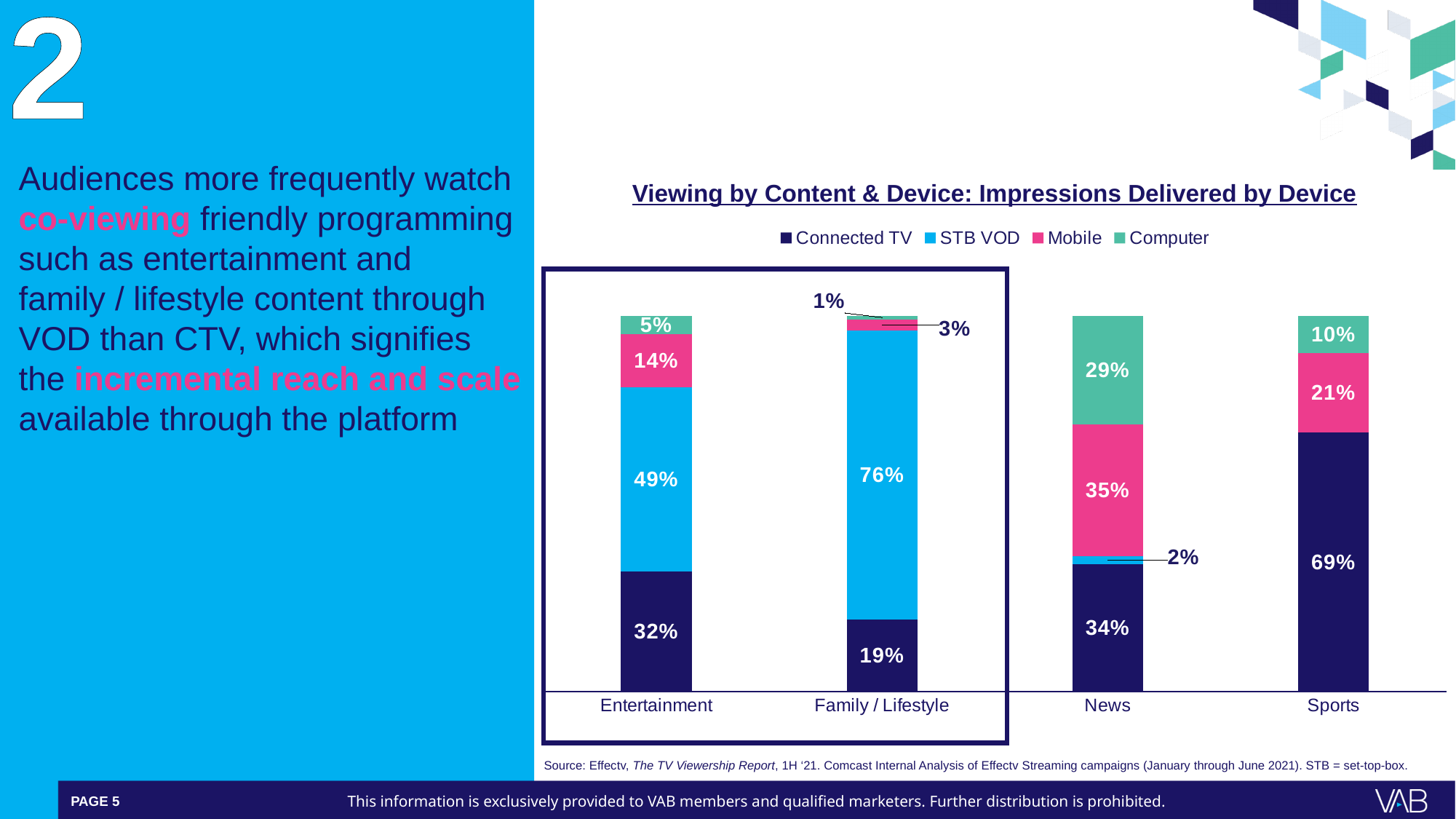
How many series does the legend list? 4 What share of impressions for News was delivered by Computer? 29% Which content category has the lowest STB VOD share among those with a labeled STB VOD value? News What is the difference between the STB VOD share for Family / Lifestyle and for Entertainment? 27% Which is larger for News: the Mobile share or the Connected TV share? Mobile What share of impressions for Sports was delivered by Mobile? 21% What share of impressions for Entertainment was delivered by STB VOD? 49% What type of chart is shown on the slide? Stacked bar chart How many content categories are shown on the x axis? 4 What share of impressions for Family / Lifestyle was delivered by Connected TV? 19% What is the title of the chart? Viewing by Content & Device: Impressions Delivered by Device Which content category has the highest Connected TV share? Sports